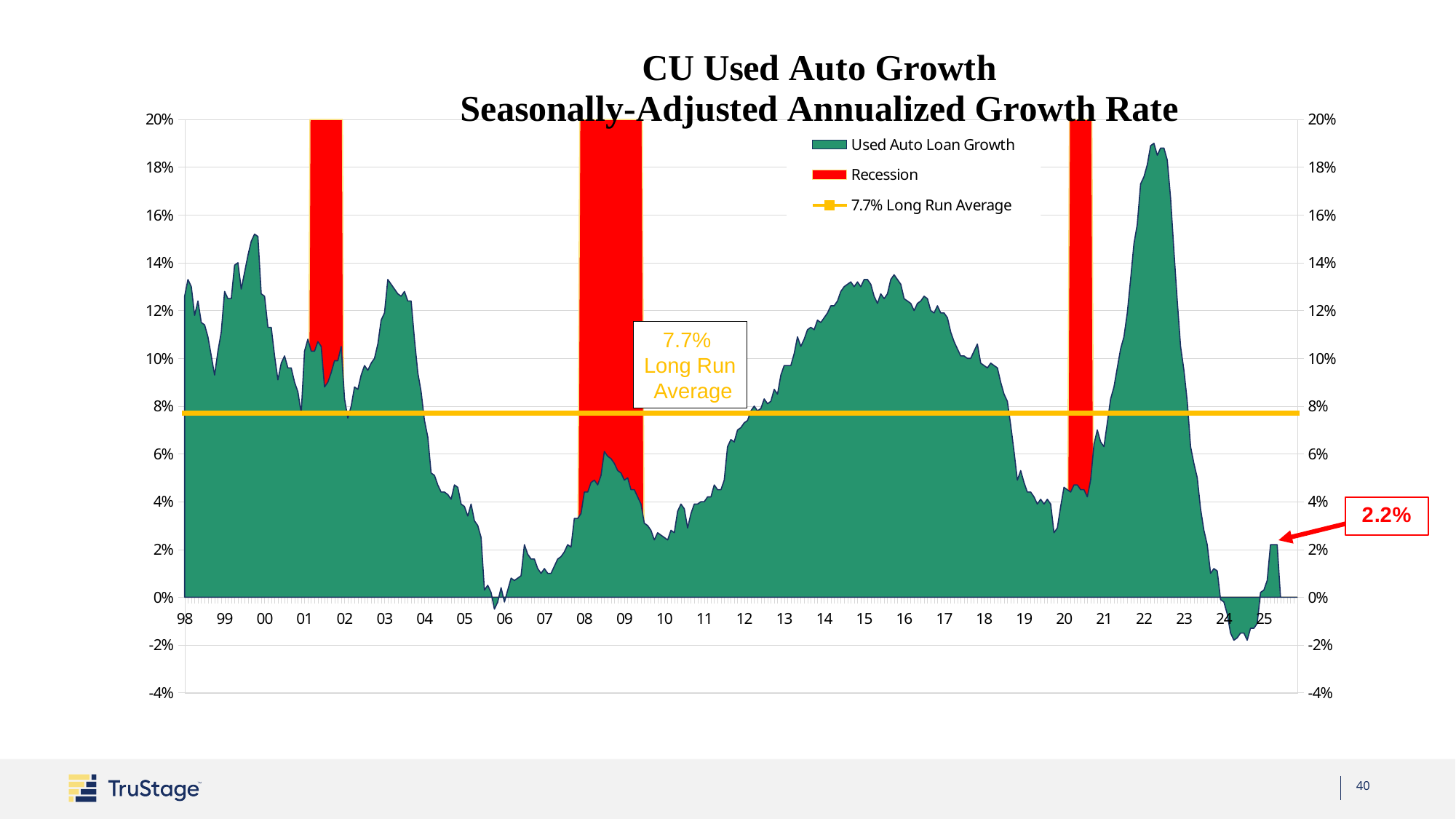
Which is larger, the latest labeled growth value or the long run average? the long run average (7.7%) By how many percentage points is the latest labeled value (2.2%) below the 7.7% long run average? 5.5 percentage points How many entries does the legend list? 3 What is the value of the long run average shown on the chart? 7.7% What is the most recent used auto loan growth value labeled on the chart? 2.2% Is the used auto loan growth value in 2024 greater or less than 0%? less Is the peak used auto loan growth value around 2022 greater or less than 16%? greater How many recession periods are shaded in red on the chart? 3 Is the used auto loan growth value in 2006 greater or less than 4%? less Does used auto loan growth rise or fall from 2022 to 2024? fall What kind of chart is shown on the slide? area chart In which year does used auto loan growth reach its highest peak on the chart? 2022